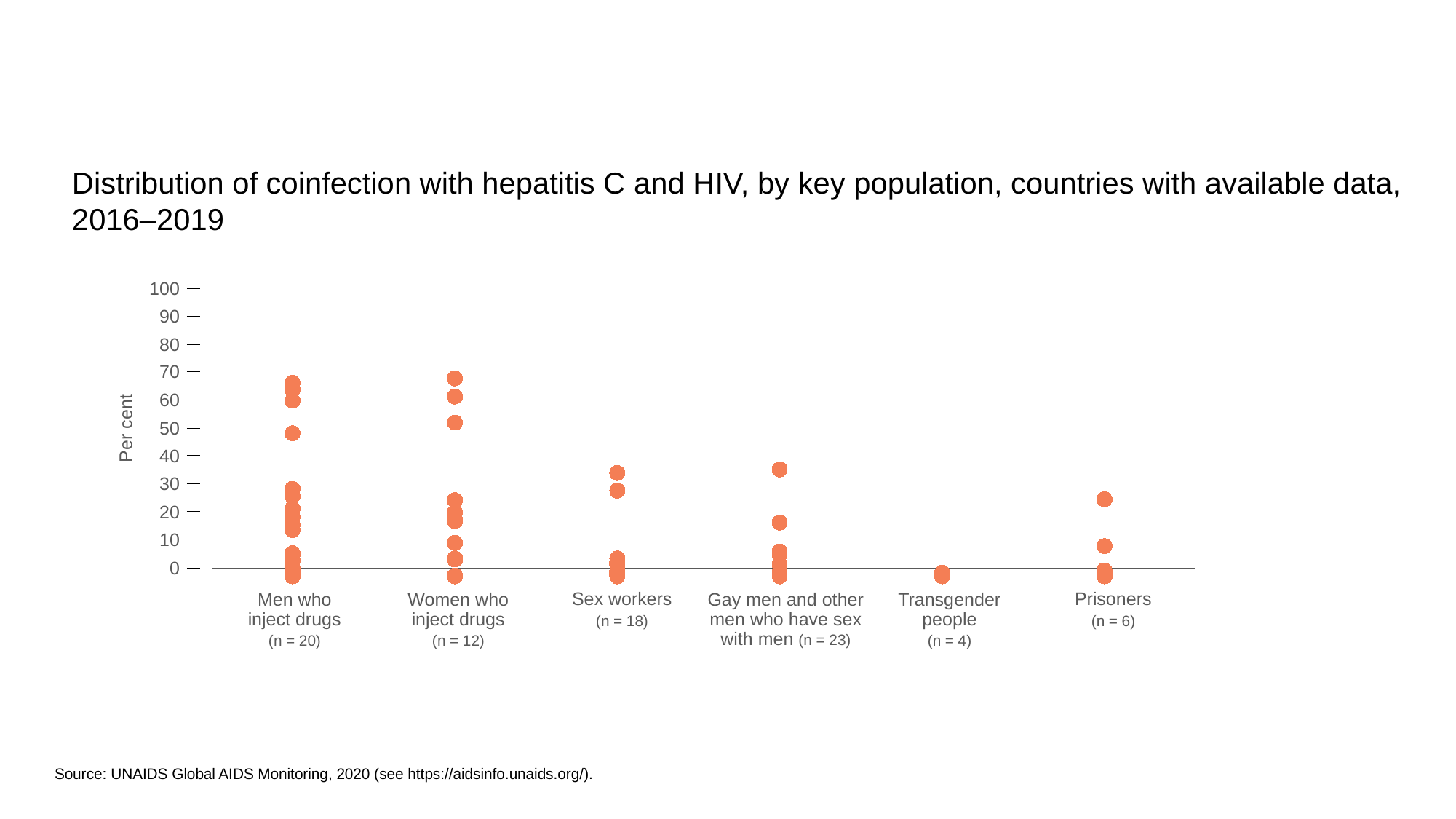
Which key population has the lowest maximum coinfection value? Transgender people Are all values for transgender people greater or less than 10? less What is the number of countries (n) for sex workers? n = 18 How many key population categories are shown along the x axis? 6 What kind of chart is shown on the slide? Dot plot (scatter plot) What is the number of countries (n) for prisoners? n = 6 What is the number of countries (n) for men who inject drugs? n = 20 What is the number of countries (n) for transgender people? n = 4 What is the number of countries (n) for women who inject drugs? n = 12 What is the number of countries (n) for gay men and other men who have sex with men? n = 23 Is the highest value for prisoners greater or less than 30? less What is the label on the y axis? Per cent